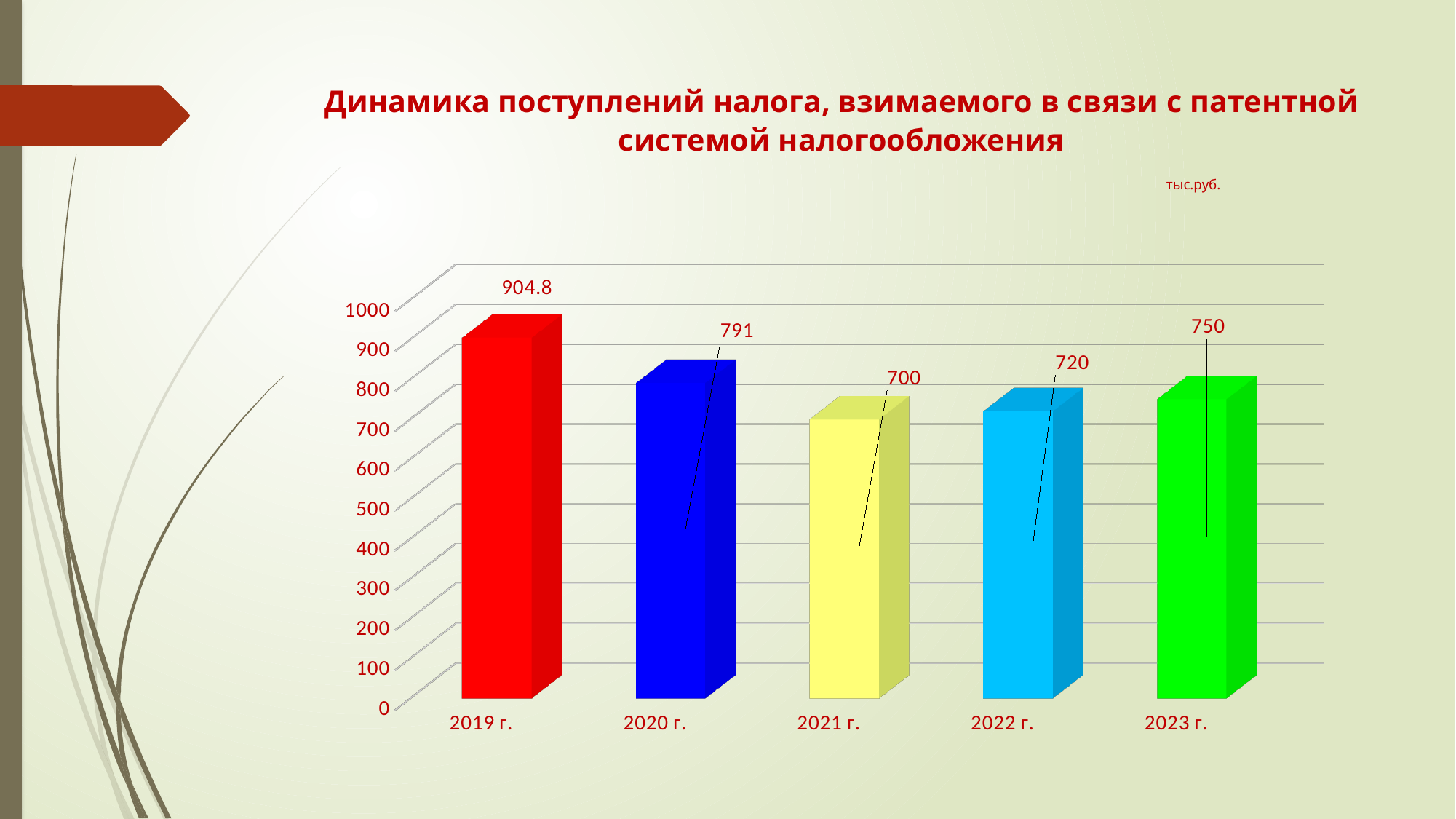
What is the value for 2023 г.? 750 Is the value for 2022 г. greater or less than 800? less What is the difference between the values for 2019 г. and 2020 г.? 113.8 What kind of chart is shown on the slide? bar chart What is the value for 2021 г.? 700 What is the difference between the values for 2023 г. and 2022 г.? 30 Which year has the lowest value? 2021 г. Which is larger, the value for 2020 г. or the value for 2023 г.? 2020 г. What is the value for 2019 г.? 904.8 Which year has the highest value? 2019 г. What unit is indicated for the values on the chart? тыс.руб. How many years are shown on the x axis? 5